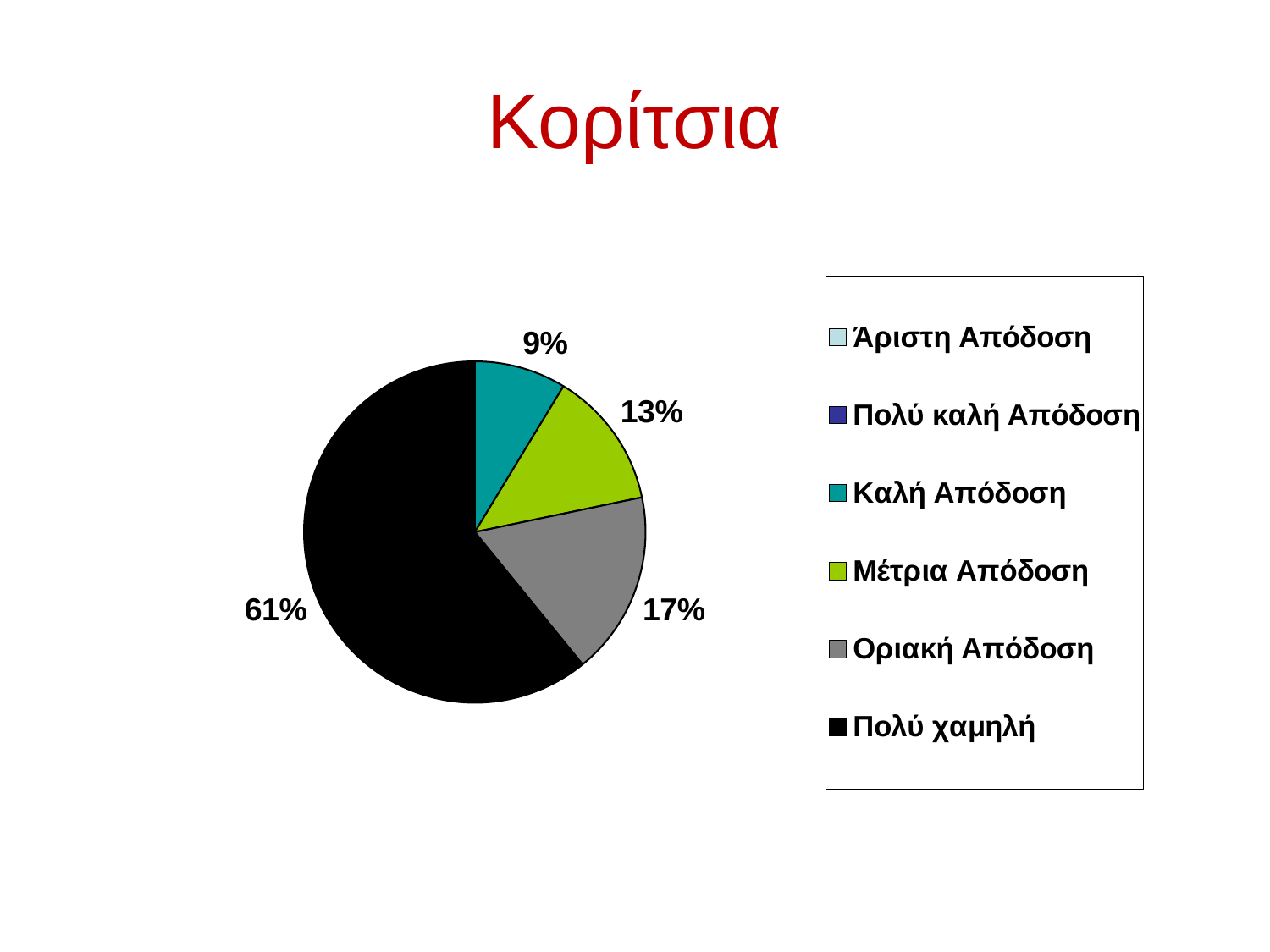
How many slices with percentage labels are visible in the pie? 4 What percentage of the pie is labelled for Πολύ χαμηλή? 61% What kind of chart is shown on the slide? pie chart Which of the labelled slices is the smallest? Καλή Απόδοση What percentage of the pie is labelled for Μέτρια Απόδοση? 13% What is the title of the slide? Κορίτσια What percentage of the pie is labelled for Καλή Απόδοση? 9% What percentage of the pie is labelled for Οριακή Απόδοση? 17% Which slice is larger, Μέτρια Απόδοση or Καλή Απόδοση? Μέτρια Απόδοση Which category has the largest slice of the pie? Πολύ χαμηλή How many entries does the legend list? 6 What is the difference in percentage points between the Πολύ χαμηλή slice and the Οριακή Απόδοση slice? 44